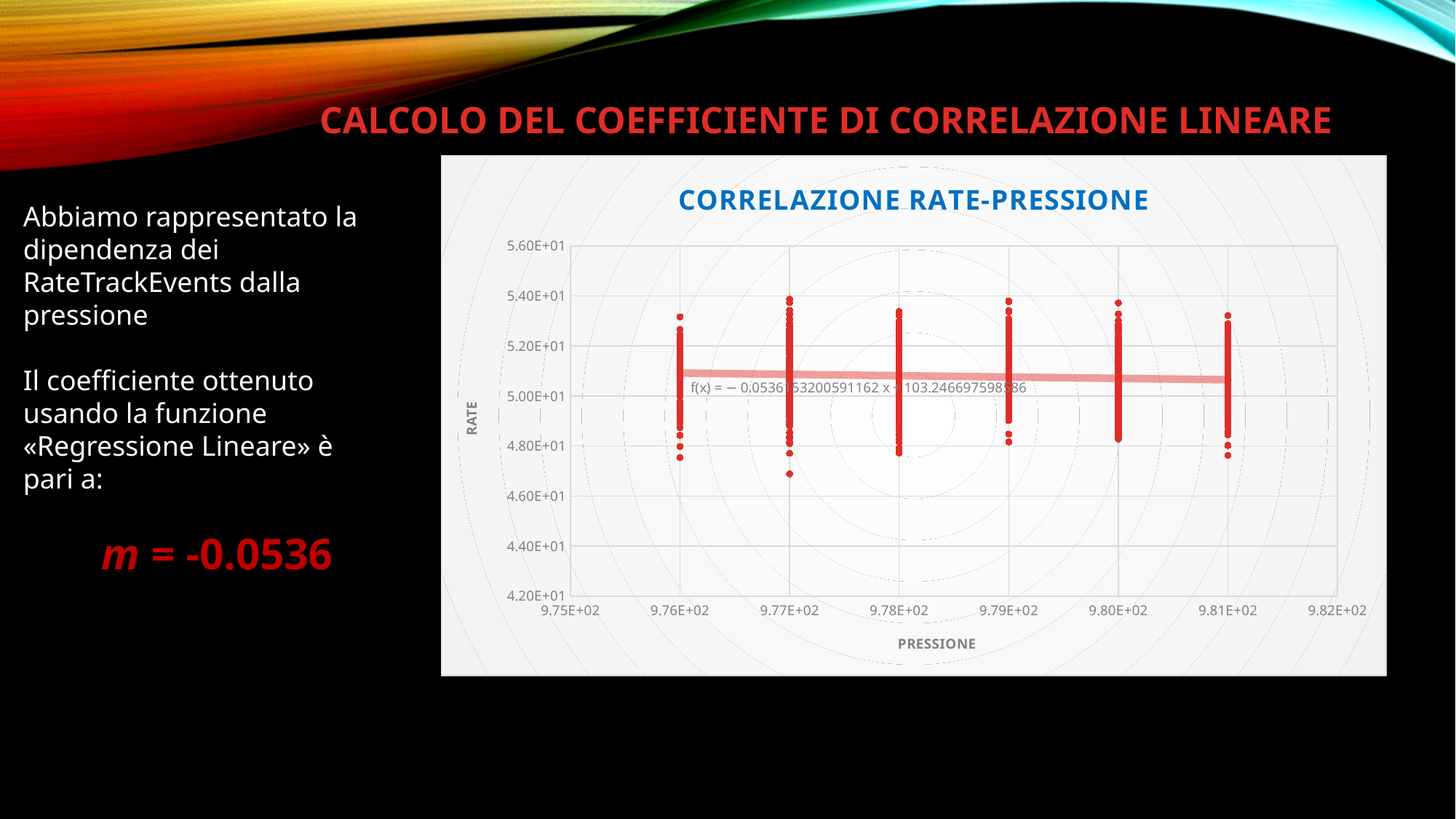
Is the value of the trend line at pressure 9.76E+02 greater or less than 5.00E+01? greater What is the lowest tick value shown on the y axis (RATE) of the chart? 4.20E+01 What is the highest tick value shown on the x axis (PRESSIONE) of the chart? 9.82E+02 What is the label of the x axis of the chart? PRESSIONE What is the title of the chart? CORRELAZIONE RATE-PRESSIONE At how many distinct pressure values are the data points clustered in the chart? 6 What kind of chart is shown on the slide? scatter chart Is the lowest rate value plotted at pressure 9.77E+02 greater or less than 4.60E+01? greater What is the slope m of the linear regression reported on the slide? -0.0536 Does the fitted trend line in the chart rise or fall as pressure increases? fall Is the highest rate value plotted at pressure 9.77E+02 greater or less than 5.60E+01? less